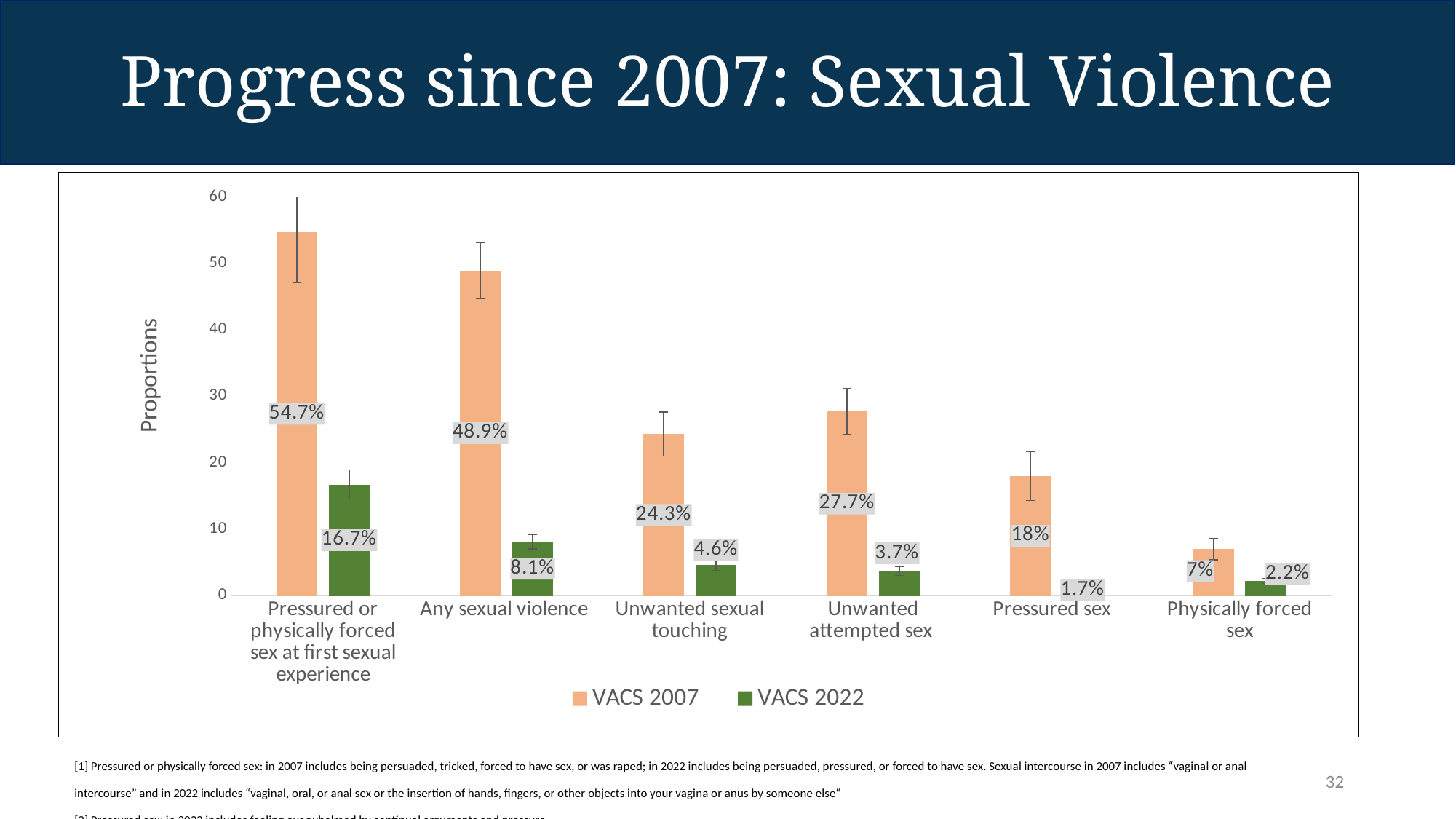
Which is larger: the VACS 2007 value for Unwanted attempted sex or the VACS 2007 value for Unwanted sexual touching? Unwanted attempted sex What is the VACS 2022 value for Unwanted sexual touching? 4.6% Which category has the highest VACS 2007 value? Pressured or physically forced sex at first sexual experience What is the VACS 2022 value for Pressured sex? 1.7% What kind of chart is shown on the slide? Bar chart What is the label of the y axis? Proportions What is the VACS 2007 value for Any sexual violence? 48.9% What is the difference between the VACS 2007 and VACS 2022 values for Physically forced sex? 4.8% Which colour represents VACS 2022 in the legend? Green Which category has the lowest VACS 2022 value? Pressured sex How many categories are shown on the x axis? 6 How many series does the legend list? 2